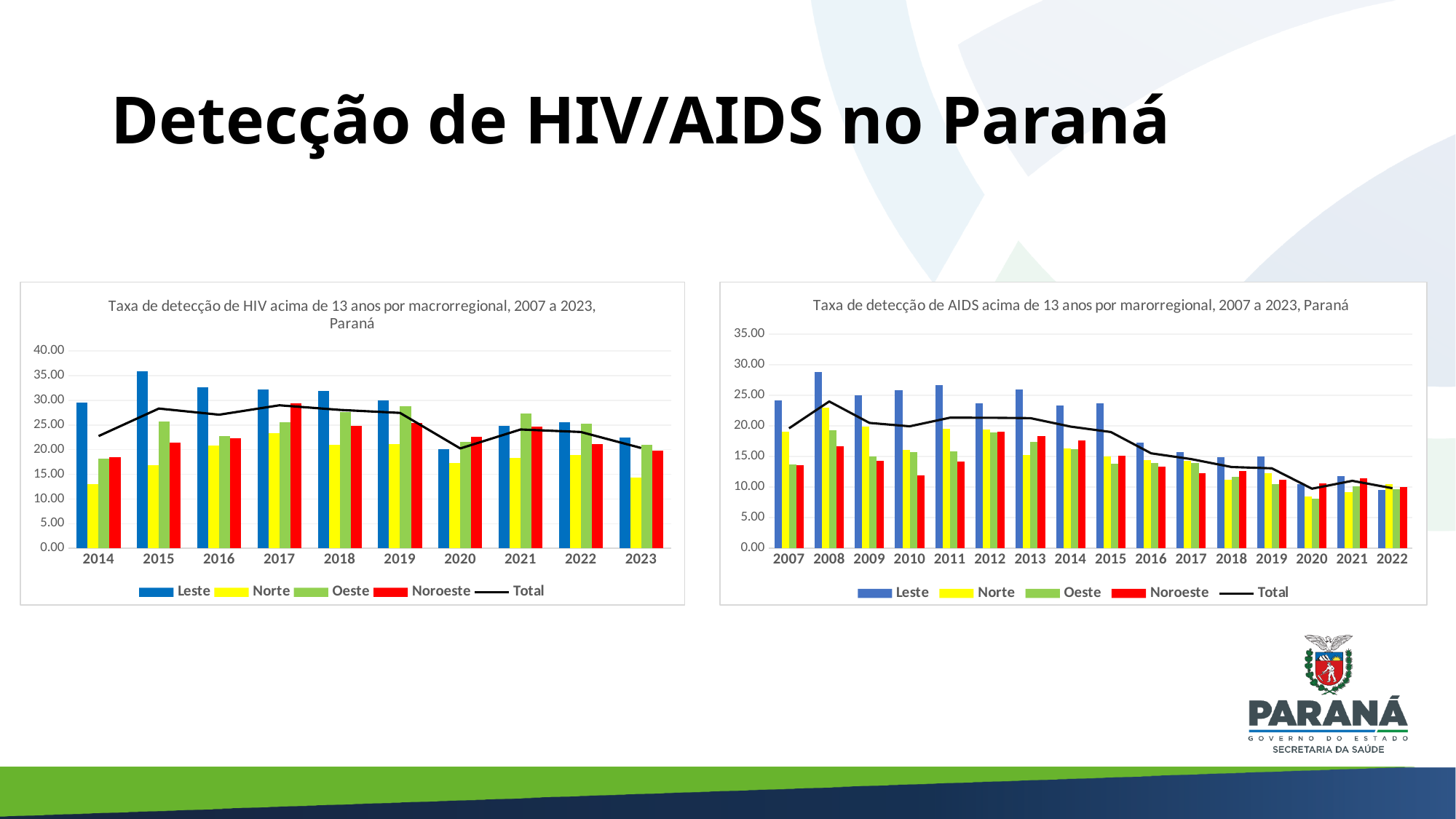
On the right chart (AIDS detection rate), does the Total line overall rise or fall from 2007 to 2022? fall On the right chart (AIDS detection rate), is the Leste value for 2008 greater or less than 25? greater What kind of chart is the left chart (HIV detection rate)? Bar chart (with a line for Total) On the left chart (HIV detection rate), is the Leste value for 2015 greater or less than 30? greater On the right chart (AIDS detection rate), how many years are shown on the x axis? 16 On the left chart (HIV detection rate), how many series does the legend list? 5 On the right chart (AIDS detection rate), in which year is the Leste bar highest? 2008 On the left chart (HIV detection rate), in which year is the Leste bar highest? 2015 On the right chart (AIDS detection rate), which series is drawn as a line rather than bars? Total On the left chart (HIV detection rate), how many years are shown on the x axis? 10 On the right chart (AIDS detection rate), which is larger in 2007, Leste or Norte? Leste On the left chart (HIV detection rate), is the Norte value for 2014 greater or less than 15? less